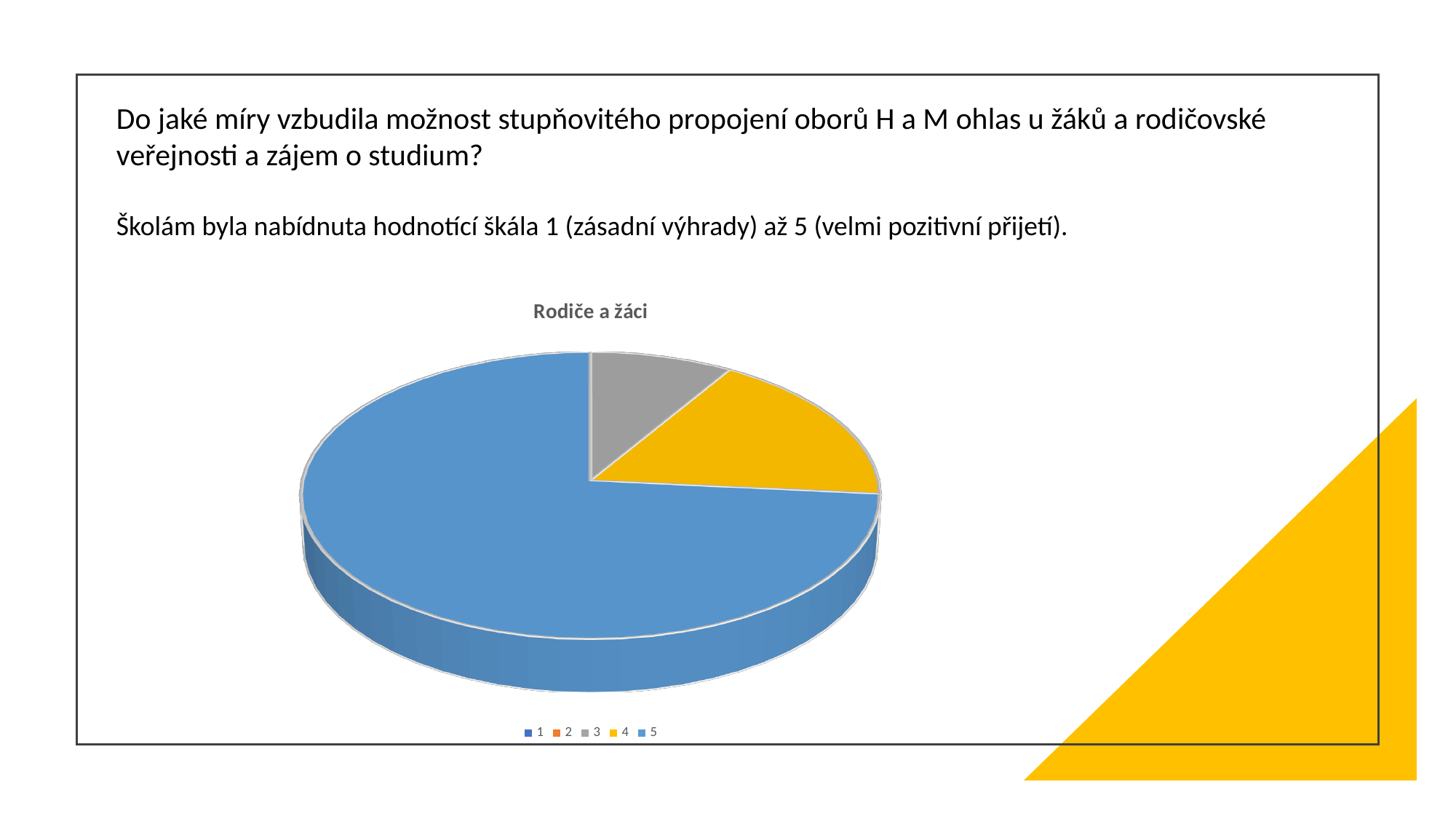
What colour is the slice for category 5? blue Which of the visible slices is the smallest? 3 What is the title of the chart? Rodiče a žáci Which slice is larger, category 4 or category 3? 4 How many entries does the chart legend list? 5 Which slice is larger, category 5 or category 4? 5 How many slices are visible in the pie? 3 Which category has the largest slice of the pie? 5 What kind of chart is shown on the slide? pie chart Does category 5 take up more or less than half of the pie? more